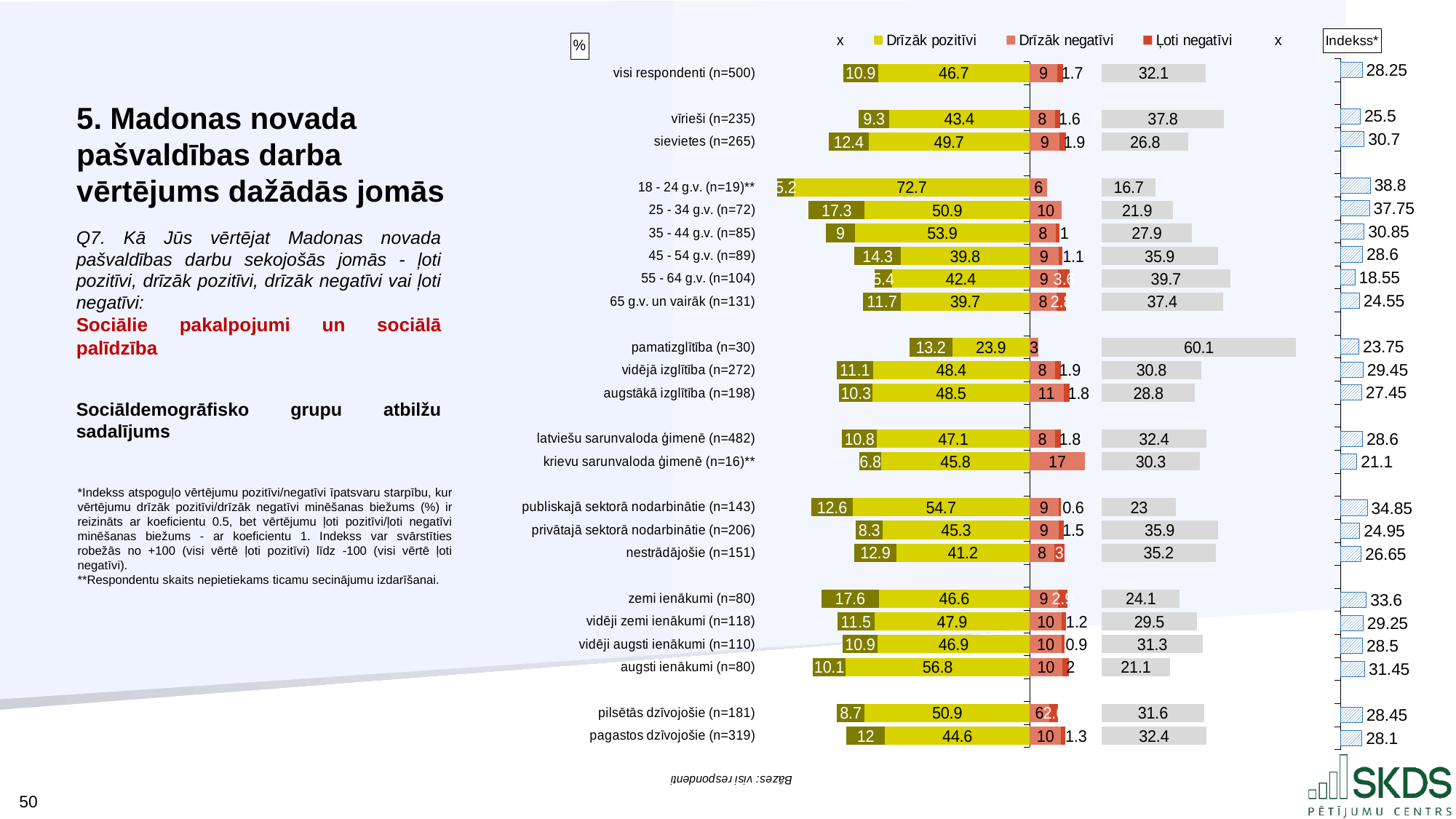
What is the grey bar value for 'pamatizglītība (n=30)'? 60.1 Which group has the highest Indekss* value? 18 - 24 g.v. (n=19)** What kind of chart is used to show the response shares? Stacked horizontal bar chart What is the 'Drīzāk negatīvi' value for 'krievu sarunvaloda ģimenē (n=16)**'? 17 What is the Indekss* value for 'augsti ienākumi (n=80)'? 31.45 How many respondent groups (rows) are shown in the chart? 23 Which has a larger 'Drīzāk pozitīvi' value: 'publiskajā sektorā nodarbinātie (n=143)' or 'privātajā sektorā nodarbinātie (n=206)'? publiskajā sektorā nodarbinātie (n=143) What is the Indekss* value for 'sievietes (n=265)'? 30.7 Which group has the lowest Indekss* value? 55 - 64 g.v. (n=104) What is the difference between the Indekss* values for 'sievietes (n=265)' and 'vīrieši (n=235)'? 5.2 What is the 'Drīzāk pozitīvi' value for 'visi respondenti (n=500)'? 46.7 Which group has the highest 'Drīzāk pozitīvi' value? 18 - 24 g.v. (n=19)**